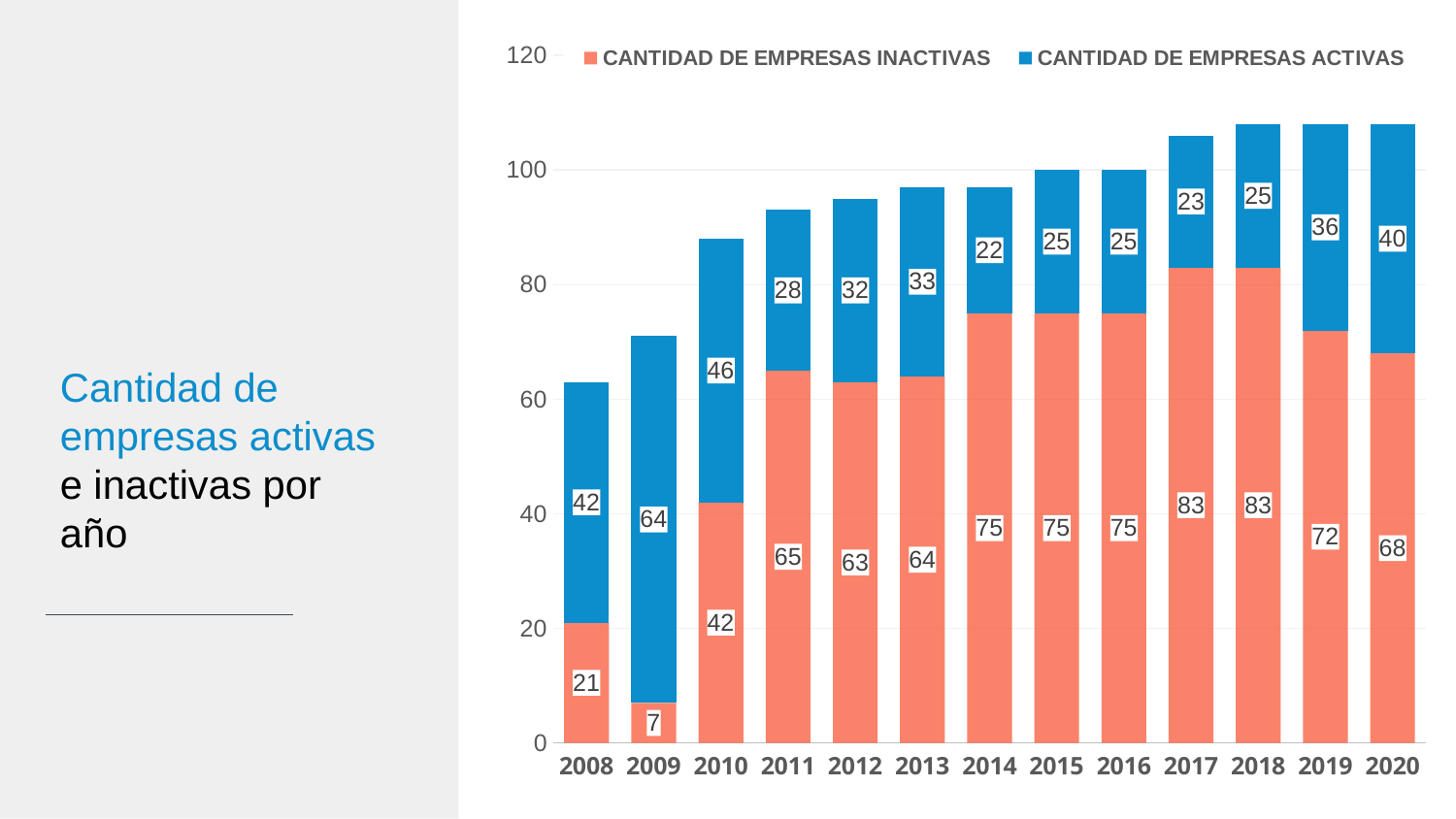
What is the value for CANTIDAD DE EMPRESAS INACTIVAS in 2010? 42 What is the value for CANTIDAD DE EMPRESAS ACTIVAS in 2019? 36 In which year is the value for CANTIDAD DE EMPRESAS INACTIVAS lowest? 2009 What is the total of the stacked bar for 2020? 108 What kind of chart is shown on the slide? Stacked bar chart Which colour represents CANTIDAD DE EMPRESAS ACTIVAS in the chart? Blue How many years are shown on the x axis? 13 How many series does the legend list? 2 Which is larger in 2010, CANTIDAD DE EMPRESAS INACTIVAS or CANTIDAD DE EMPRESAS ACTIVAS? CANTIDAD DE EMPRESAS ACTIVAS In which year is the value for CANTIDAD DE EMPRESAS ACTIVAS highest? 2009 What is the total of the stacked bar for 2008? 63 What is the difference between CANTIDAD DE EMPRESAS INACTIVAS and CANTIDAD DE EMPRESAS ACTIVAS in 2017? 60